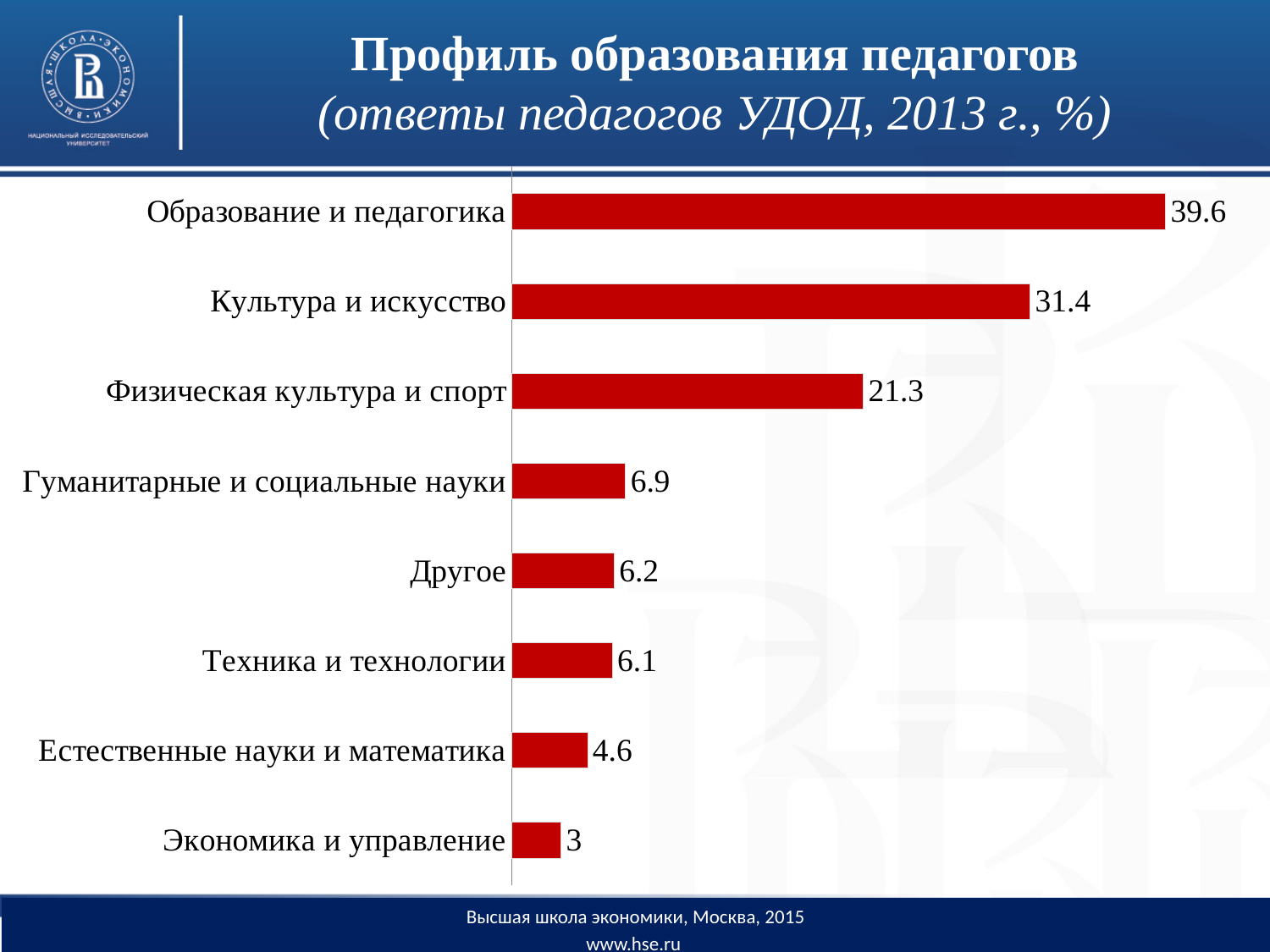
What is the difference between the values for Образование и педагогика and Культура и искусство? 8.2 What is the value for Экономика и управление? 3 Which category has the lowest value? Экономика и управление How many categories are shown in the chart? 8 Which category has the highest value? Образование и педагогика Which is larger, the value for Культура и искусство or the value for Физическая культура и спорт? Культура и искусство What colour are the bars in the chart? red What is the value for Физическая культура и спорт? 21.3 What kind of chart is shown on the slide? bar chart What is the difference between the values for Физическая культура и спорт and Гуманитарные и социальные науки? 14.4 What is the value for Образование и педагогика? 39.6 What is the value for Естественные науки и математика? 4.6